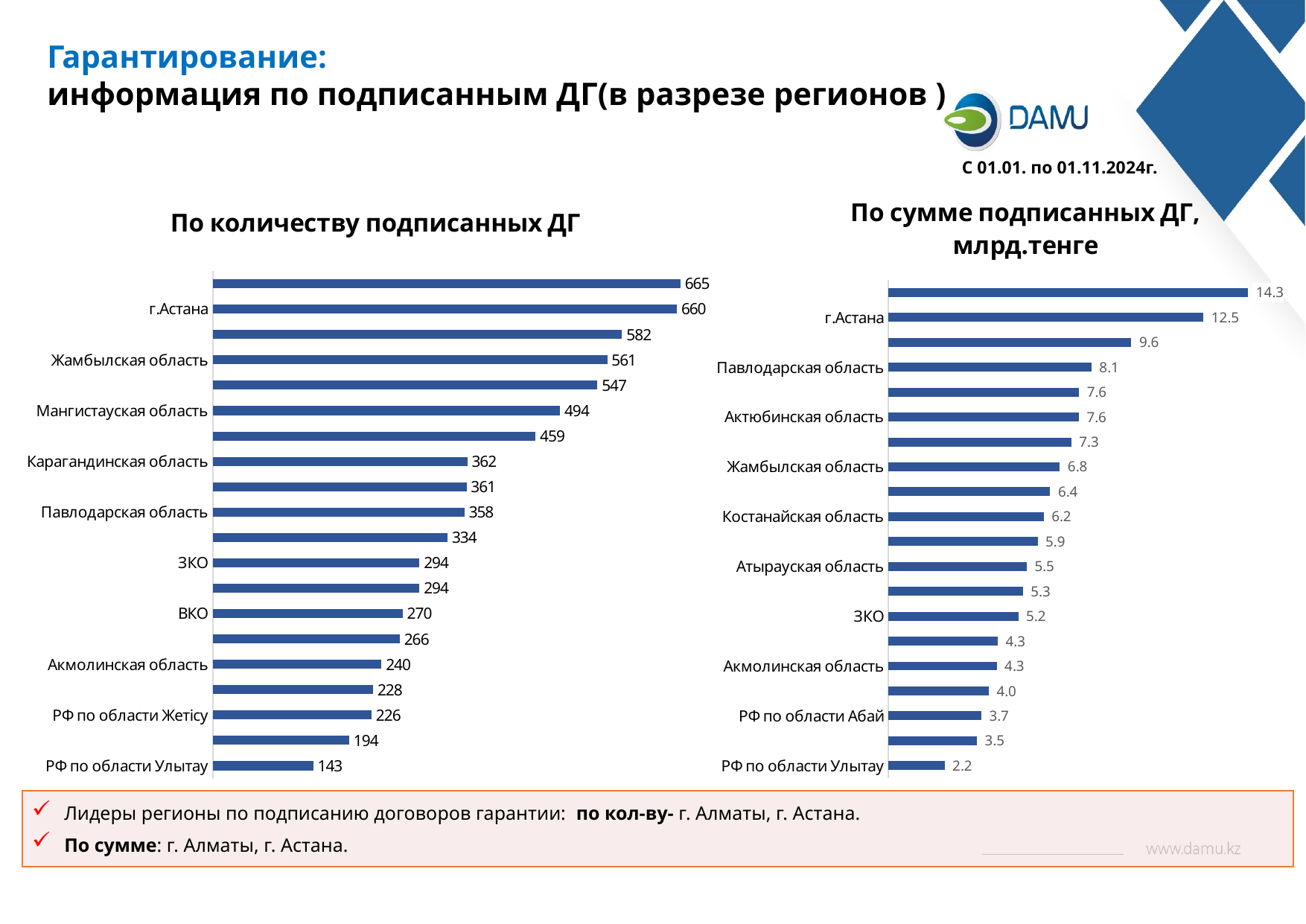
In the chart 'По количеству подписанных ДГ', what is the value for Жамбылская область? 561 In the chart 'По сумме подписанных ДГ, млрд.тенге', what is the highest value shown? 14.3 In the chart 'По сумме подписанных ДГ, млрд.тенге', what is the value for Павлодарская область? 8.1 In the chart 'По сумме подписанных ДГ, млрд.тенге', what is the value for г.Астана? 12.5 In the chart 'По количеству подписанных ДГ', which labelled region has the lowest value? РФ по области Улытау In the chart 'По количеству подписанных ДГ', what is the difference between Мангистауская область and Карагандинская область? 132 In the chart 'По количеству подписанных ДГ', what is the value for г.Астана? 660 In the chart 'По сумме подписанных ДГ, млрд.тенге', which is larger: Атырауская область or Акмолинская область? Атырауская область In the chart 'По сумме подписанных ДГ, млрд.тенге', what is the difference between Актюбинская область and Костанайская область? 1.4 In the chart 'По количеству подписанных ДГ', which is larger: ЗКО or ВКО? ЗКО In the chart 'По количеству подписанных ДГ', how many bars are plotted? 20 What type of chart is 'По сумме подписанных ДГ, млрд.тенге'? Bar chart